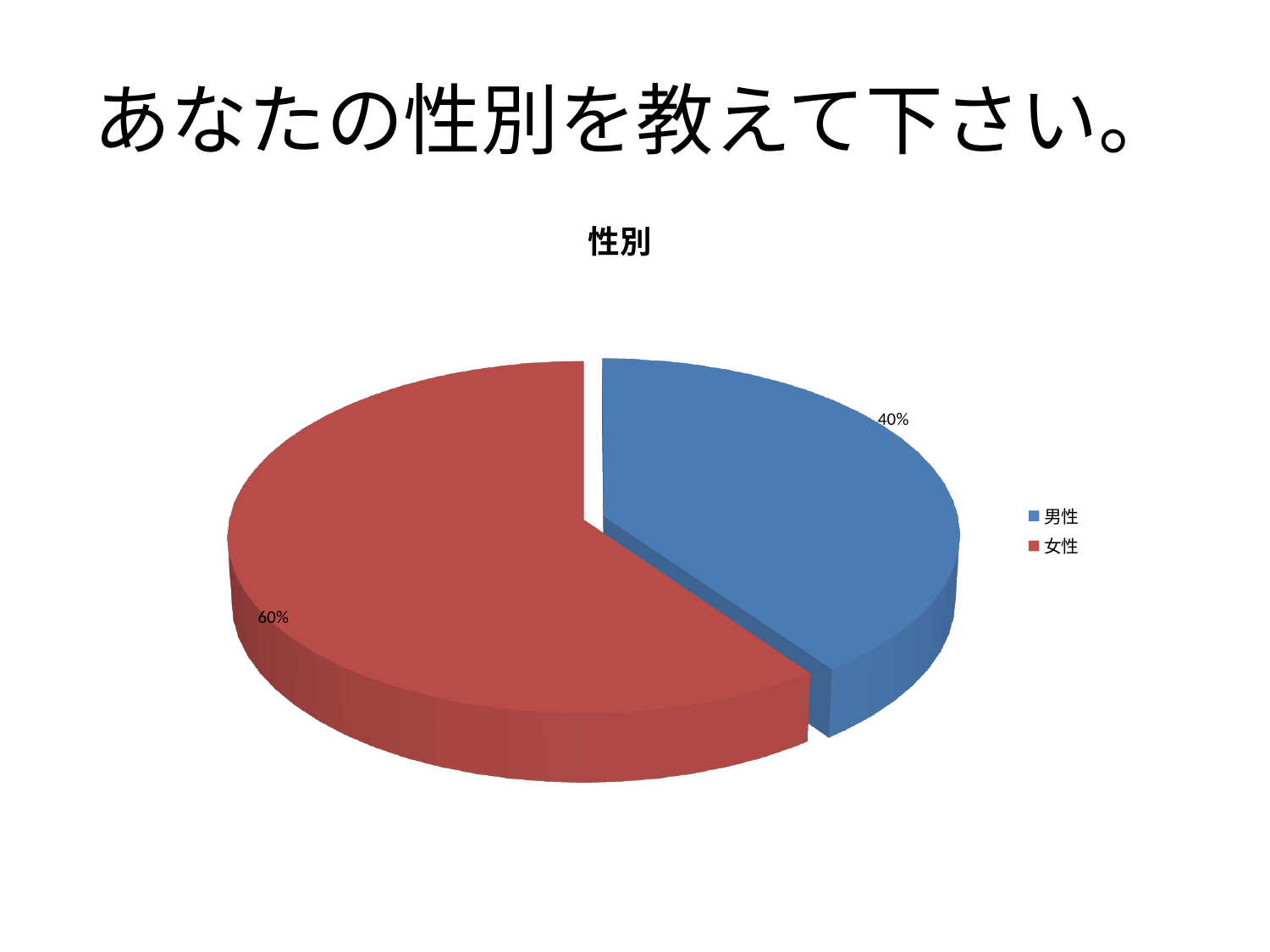
How many entries does the legend list? 2 What colour is the slice for 男性? blue Which category has the largest slice of the pie? 女性 What share of the pie does 女性 represent? 60% What is the difference between the share for 女性 and the share for 男性? 20% What share of the pie does 男性 represent? 40% How many categories does the pie chart show? 2 Which is larger, the share for 男性 or the share for 女性? 女性 What is the chart's title? 性別 Which category has the smallest slice of the pie? 男性 What kind of chart is shown on the slide? pie chart